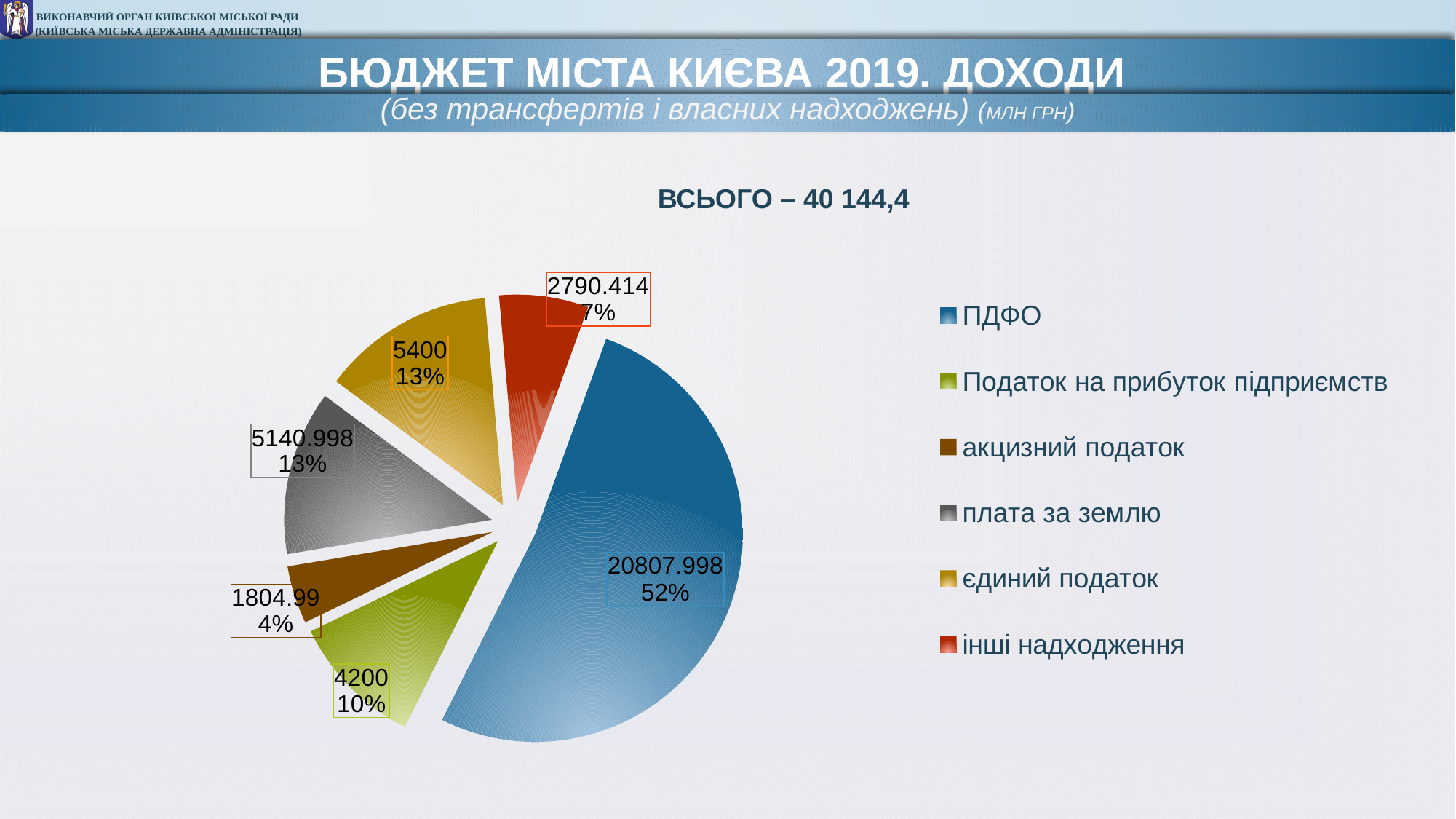
How many categories does the pie chart show? 6 What value is shown for єдиний податок? 5400 What total is stated above the pie chart? 40 144,4 Which category has the smallest slice in the pie chart? акцизний податок What value is shown for ПДФО in the pie chart? 20807.998 What is the difference between the values for ПДФО and Податок на прибуток підприємств? 16607.998 What kind of chart is shown on the slide? pie chart What percentage share does ПДФО have in the pie chart? 52% Which is larger: the value for плата за землю or the value for інші надходження? плата за землю Which category has the largest slice in the pie chart? ПДФО What percentage share does інші надходження have? 7% What value is shown for акцизний податок? 1804.99